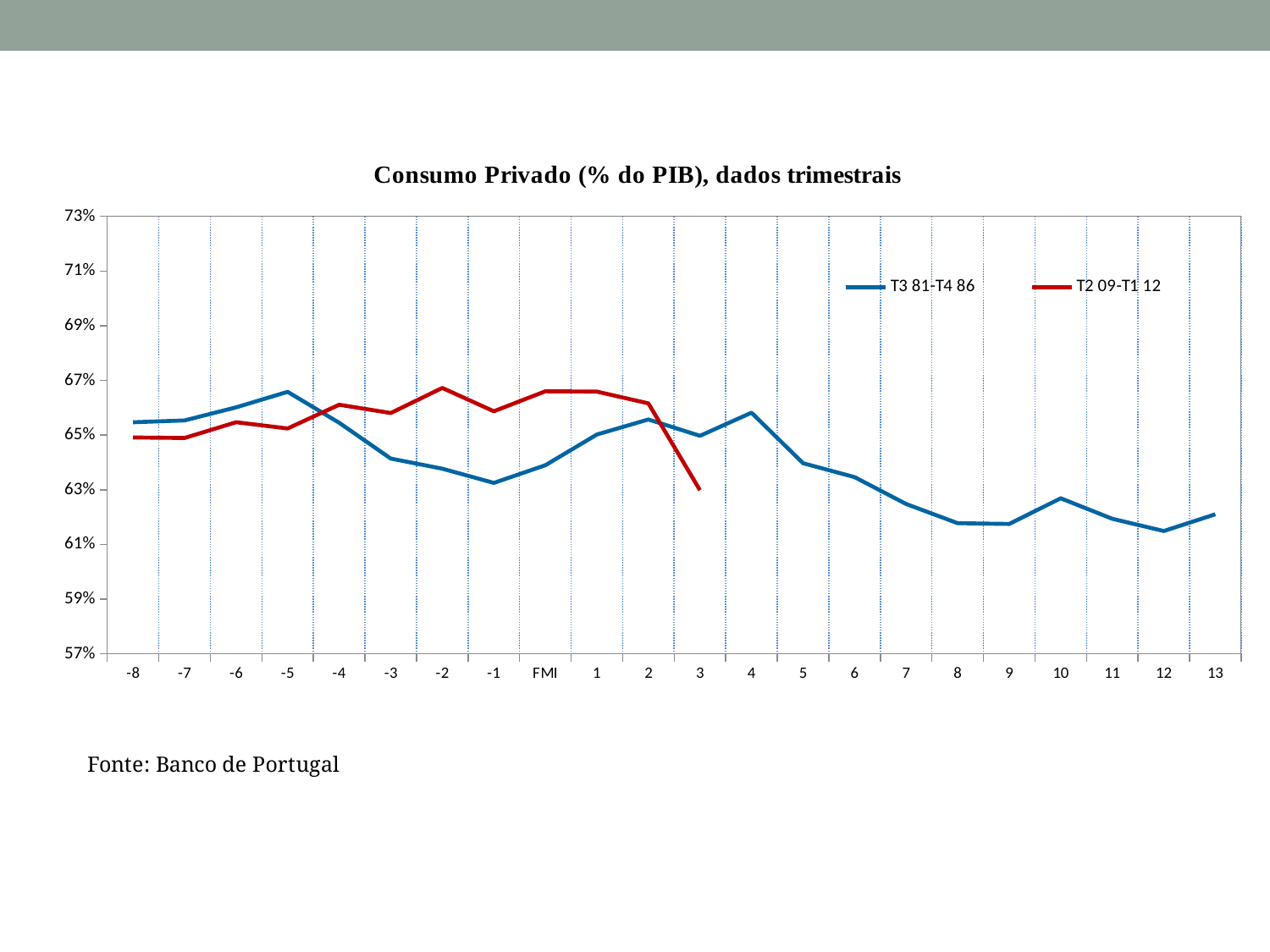
What is the title of the chart? Consumo Privado (% do PIB), dados trimestrais At -3, which series has the larger value, T3 81-T4 86 or T2 09-T1 12? T2 09-T1 12 Does the T2 09-T1 12 series rise or fall between 2 and 3? fall Is the value for T2 09-T1 12 at -8 greater or less than 67%? less How many series does the legend list? 2 Is the value for T3 81-T4 86 at 12 greater or less than 63%? less What colour is the line for the T2 09-T1 12 series? red At which x-axis point does the T3 81-T4 86 series reach its highest value? -5 How many categories are shown on the x axis? 22 Is the value for T3 81-T4 86 at -5 greater or less than 65%? greater What kind of chart is shown on the slide? line chart